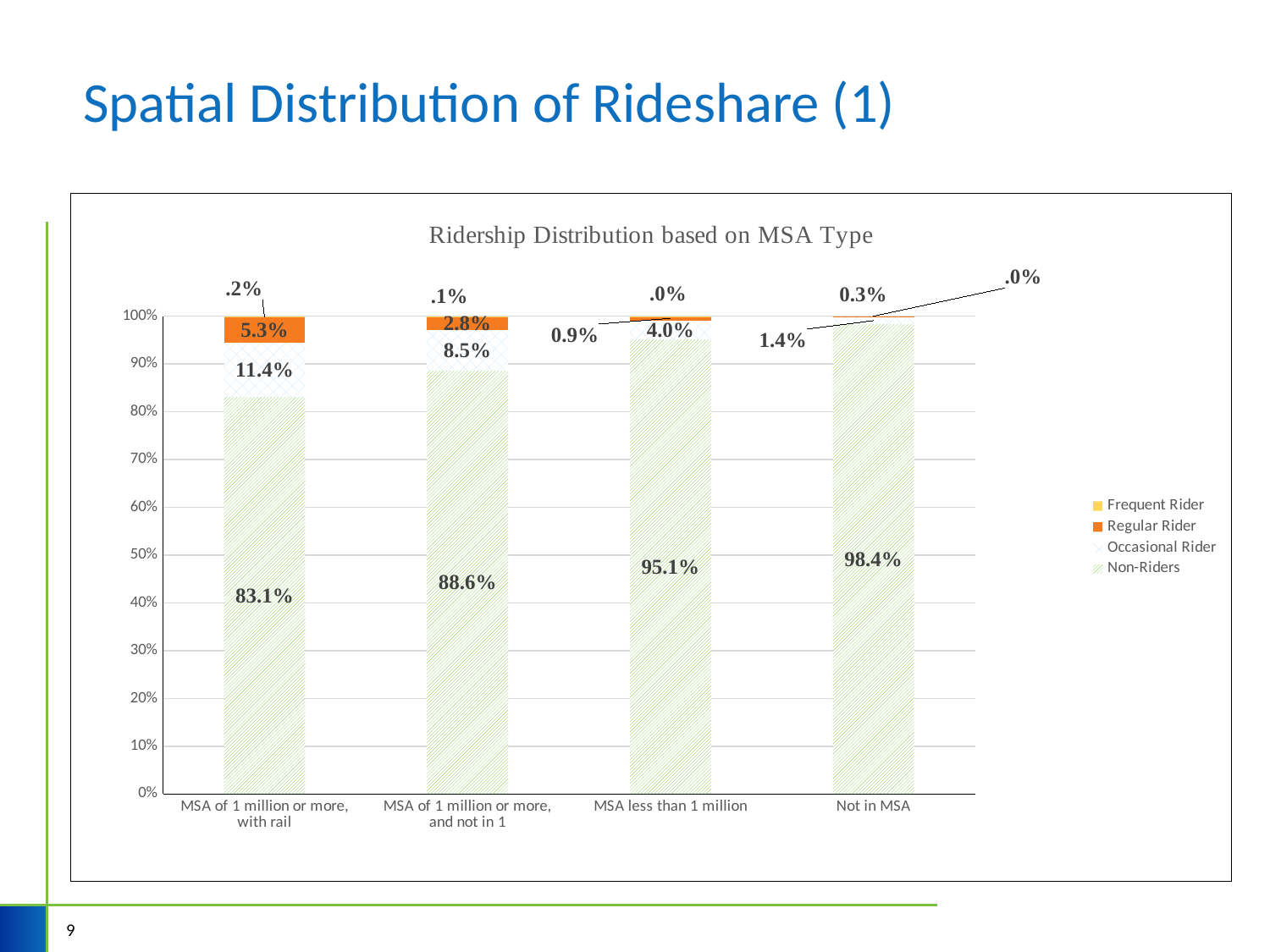
Which category has the highest Non-Riders share? Not in MSA What is the difference in Non-Riders share between 'Not in MSA' and 'MSA of 1 million or more, with rail'? 15.3% Which category has the lowest Non-Riders share? MSA of 1 million or more, with rail What type of chart is shown on the slide? stacked bar chart How many series does the legend list? 4 Does the Non-Riders share rise or fall moving from left to right across the categories? rise What is the Non-Riders share for 'MSA of 1 million or more, with rail'? 83.1% What is the Occasional Rider share for 'MSA of 1 million or more, and not in 1'? 8.5% What is the Regular Rider share for 'MSA of 1 million or more, with rail'? 5.3% What is the title of the chart? Ridership Distribution based on MSA Type What is the Non-Riders share for 'Not in MSA'? 98.4% How many MSA type categories are shown on the x axis? 4